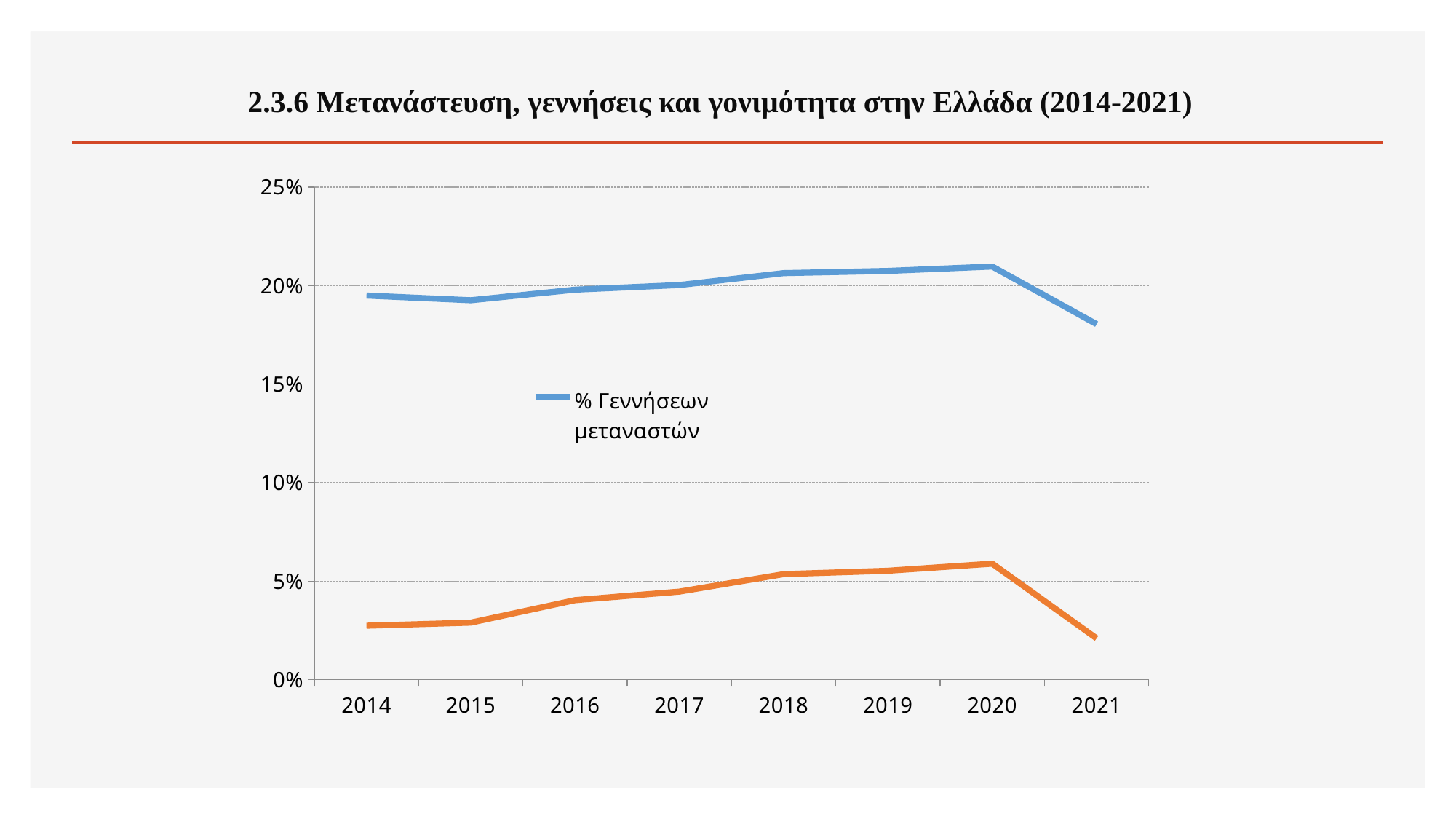
In which year does the orange line reach its lowest value? 2021 What is the title of the slide? 2.3.6 Μετανάστευση, γεννήσεις και γονιμότητα στην Ελλάδα (2014-2021) Is the value of the blue line (% Γεννήσεων μεταναστών) in 2014 greater or less than 15%? greater Is the value of the orange line in 2020 greater or less than 5%? greater What is the legend entry for the blue line? % Γεννήσεων μεταναστών In which year does the blue line (% Γεννήσεων μεταναστών) reach its highest value? 2020 Is the value of the orange line in 2014 greater or less than 5%? less How many years are plotted along the x axis? 8 How many series does the legend list? 1 What kind of chart is shown on the slide? line chart Does the blue line (% Γεννήσεων μεταναστών) rise or fall from 2020 to 2021? fall